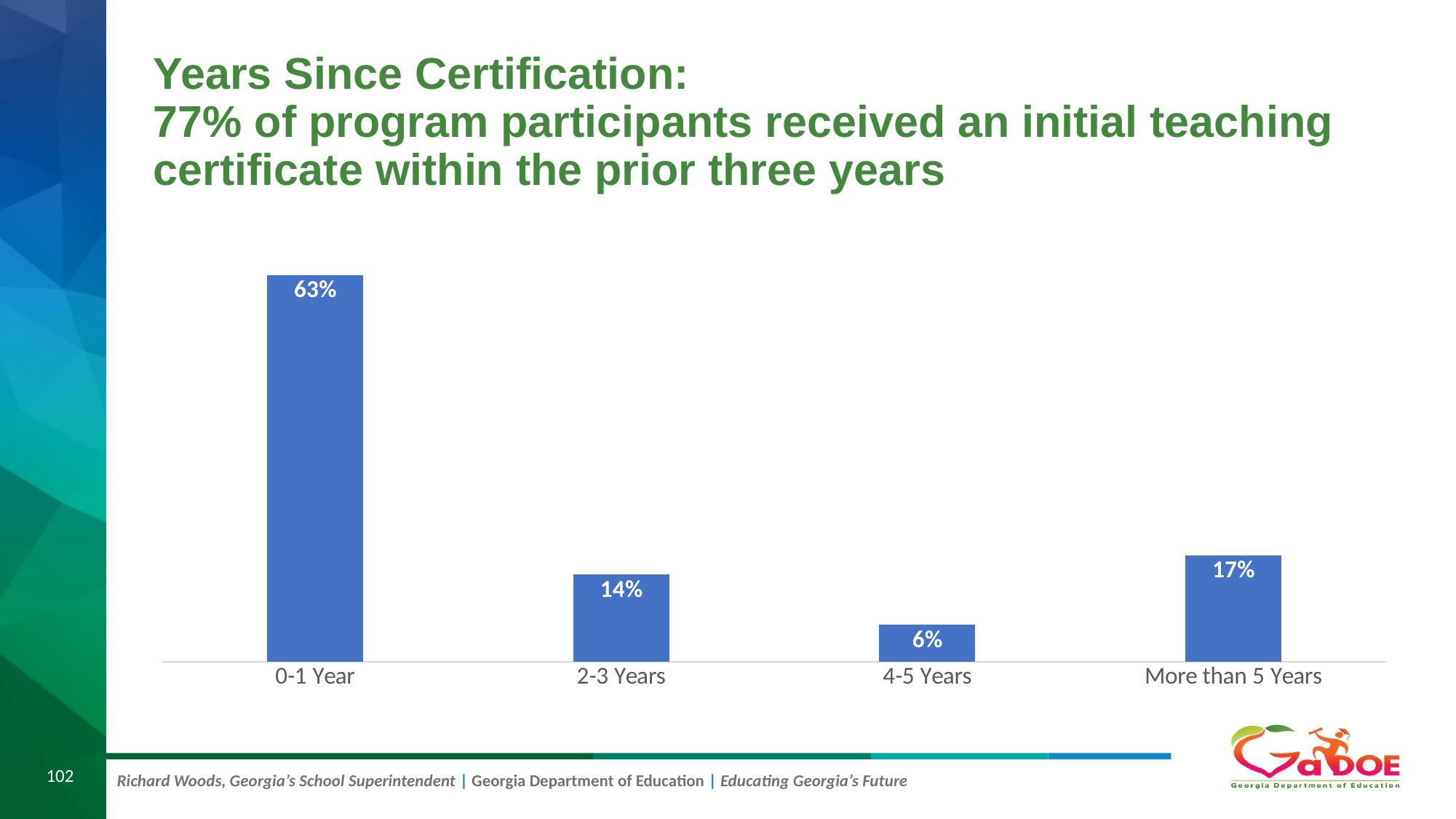
Which is larger, the value for 2-3 Years or the value for More than 5 Years? More than 5 Years How many categories are shown on the x axis of the chart? 4 What is the combined value of the 0-1 Year and 2-3 Years categories? 77% What is the difference between the More than 5 Years value and the 4-5 Years value? 11% What kind of chart is shown on the slide? Bar chart What is the value shown for the More than 5 Years category? 17% Which category has the highest value? 0-1 Year What percentage of program participants are in the 0-1 Year category? 63% What is the difference between the 0-1 Year value and the 2-3 Years value? 49% Which category has the lowest value? 4-5 Years What is the value shown for the 4-5 Years category? 6% What is the value shown for the 2-3 Years category? 14%